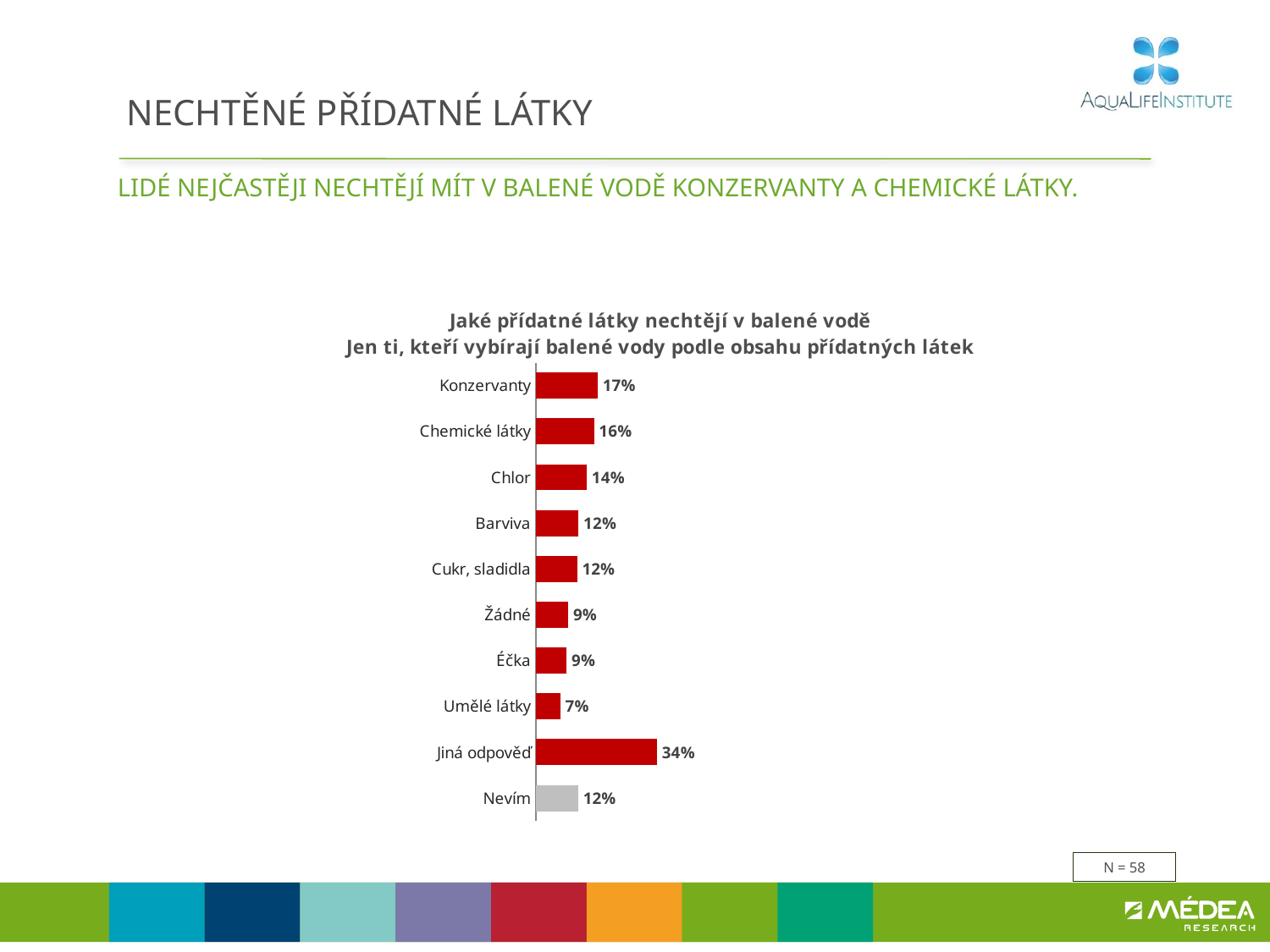
What is the difference between the values for Konzervanty and Chemické látky? 1% What is the value for Konzervanty? 17% What kind of chart is shown on the slide? Bar chart How many categories are shown in the chart? 10 Which is larger, the value for Chlor or the value for Barviva? Chlor Which category has the highest value? Jiná odpověď What is the value for Jiná odpověď? 34% What is the difference between the values for Jiná odpověď and Nevím? 22% What is the value for Umělé látky? 7% Which category's bar is shown in grey rather than red? Nevím What is the value for Chlor? 14% Which category has the lowest value? Umělé látky